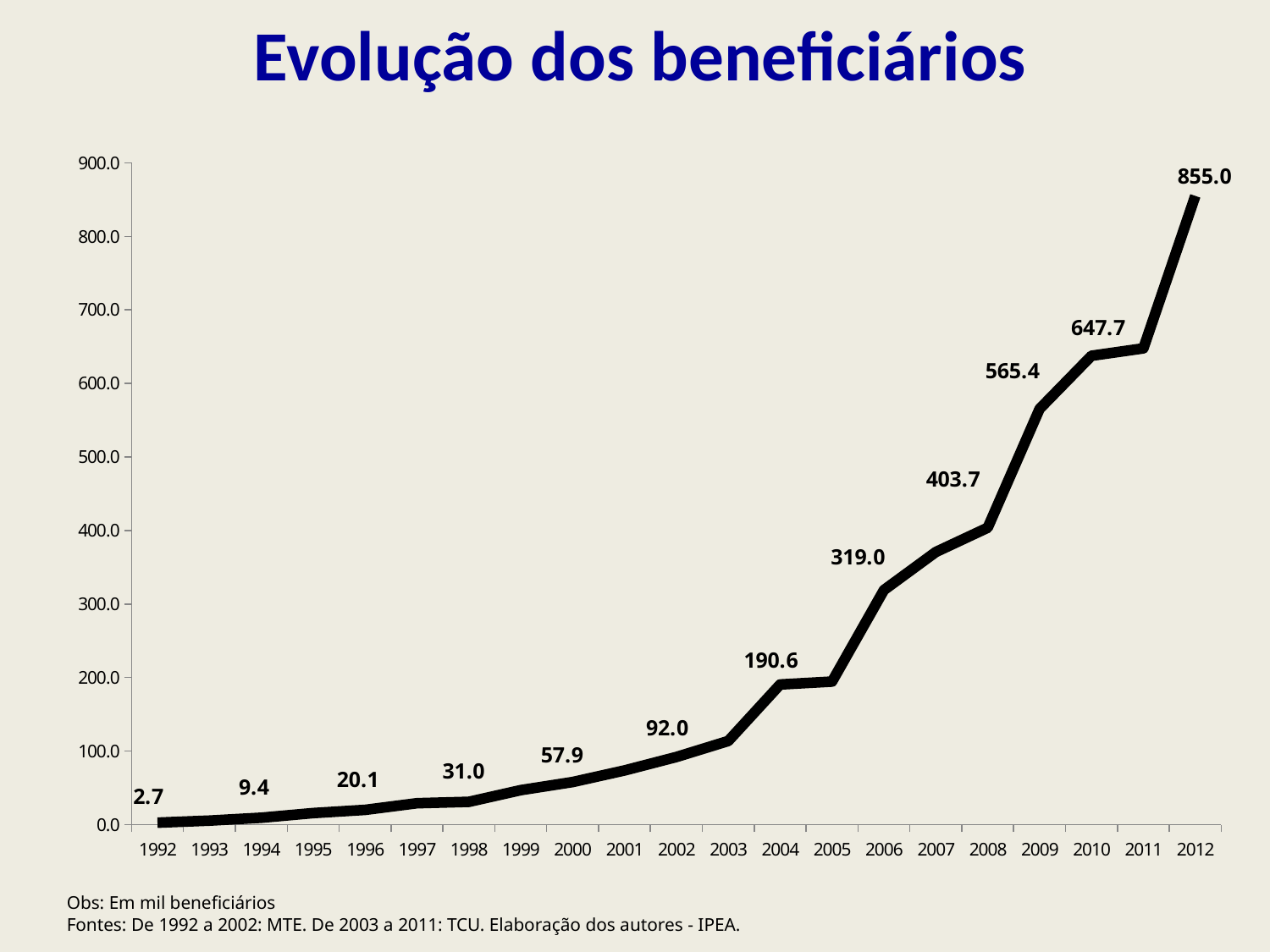
Which year has the lowest value? 1992 What is the value for 1992? 2.7 What is the value for 2006? 319.0 How many years are shown on the x axis? 21 Do the values generally rise or fall from 1992 to 2012? rise What type of chart is shown on the slide? line chart What is the value for 2009? 565.4 Which is larger, the value for 2004 or the value for 2006? 2006 Is the value for 2011 greater or less than 600.0? greater What is the value for 2012? 855.0 Which year has the highest value? 2012